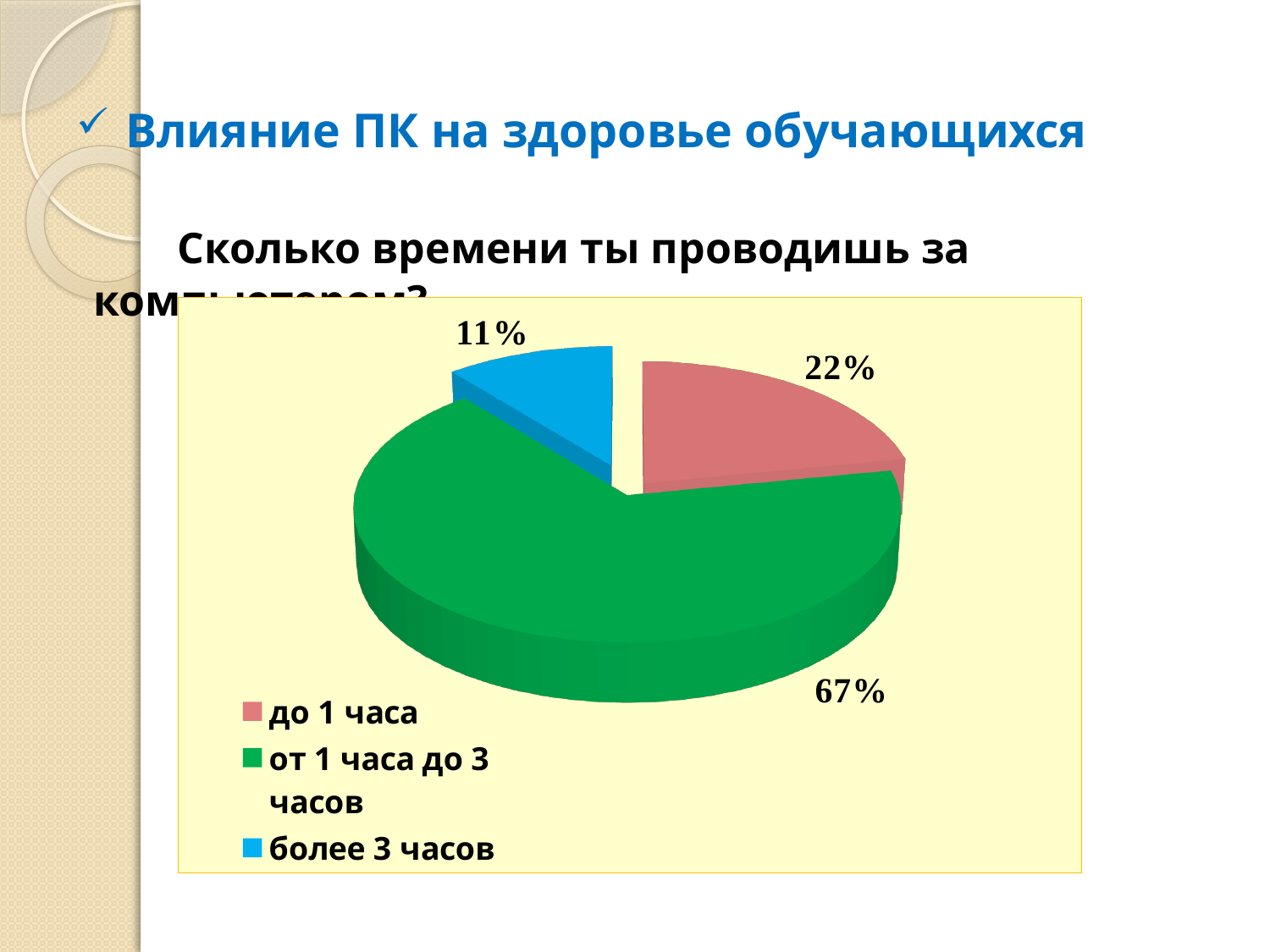
How many slices does the pie chart have? 3 What share of the pie is labelled "до 1 часа"? 22% What share of the pie is labelled "от 1 часа до 3 часов"? 67% What kind of chart is shown on the slide? pie chart What share of the pie is labelled "более 3 часов"? 11% How many entries does the legend list? 3 Which is larger: the slice for "до 1 часа" or the slice for "более 3 часов"? до 1 часа What colour is the slice for "более 3 часов"? blue Which category has the smallest slice of the pie? более 3 часов What is the difference in percentage points between "до 1 часа" and "более 3 часов"? 11 Which category has the largest slice of the pie? от 1 часа до 3 часов What is the difference in percentage points between "от 1 часа до 3 часов" and "до 1 часа"? 45